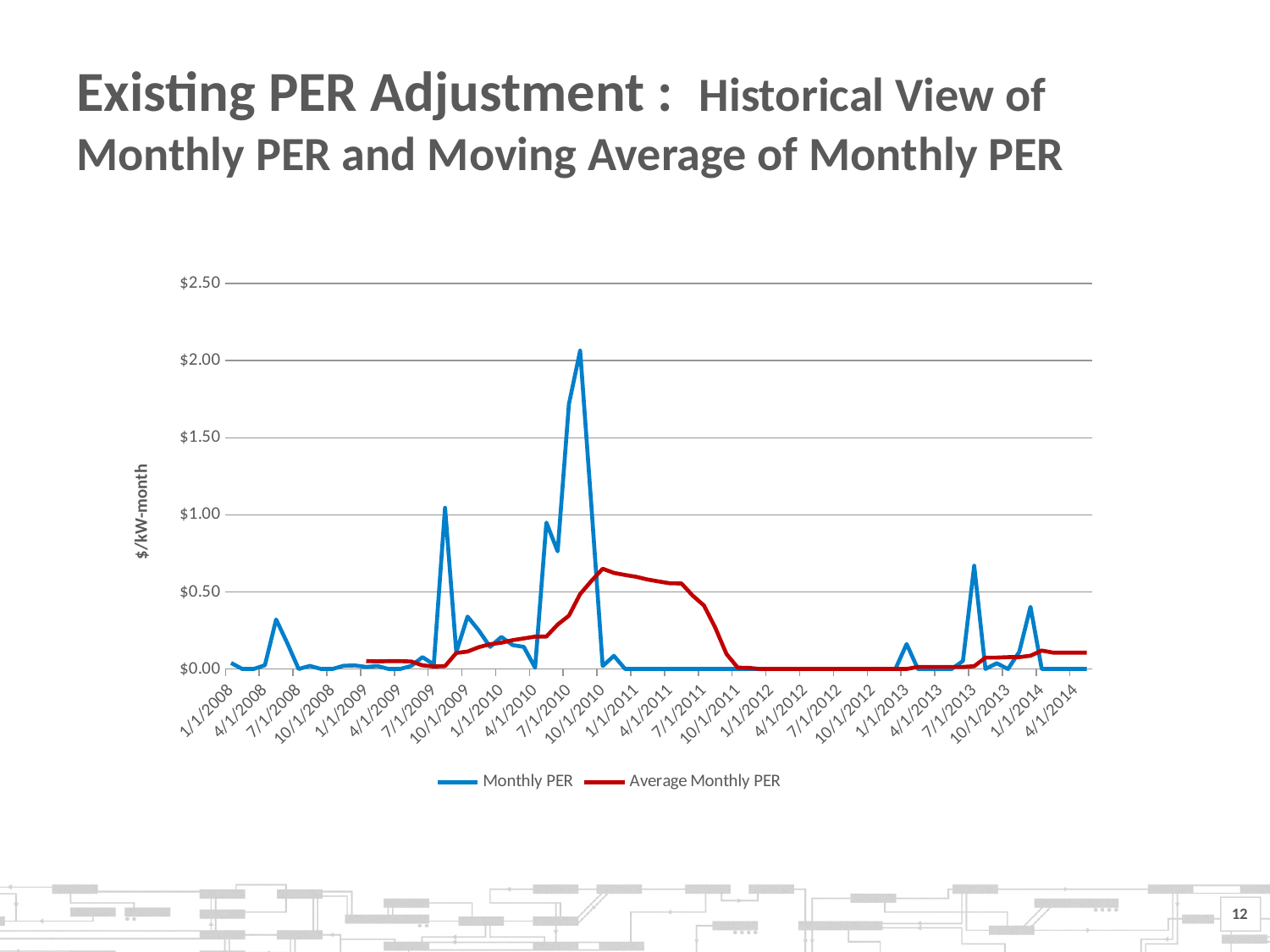
Does the Average Monthly PER series rise or fall between 10/1/2010 and 10/1/2011? fall What kind of chart is shown on the slide? Line chart What are the two series named in the legend? Monthly PER and Average Monthly PER Does the Monthly PER series rise or fall between 4/1/2010 and 7/1/2010? rise What is the label on the vertical axis? $/kW-month Is the peak value of the Monthly PER series greater or less than $1.50? greater Is the peak value of the Average Monthly PER series greater or less than $0.50? greater How many series does the legend list? 2 Is the peak value of the Average Monthly PER series greater or less than $1.00? less Which series reaches the higher peak value, Monthly PER or Average Monthly PER? Monthly PER What is the highest value shown on the vertical axis? $2.50